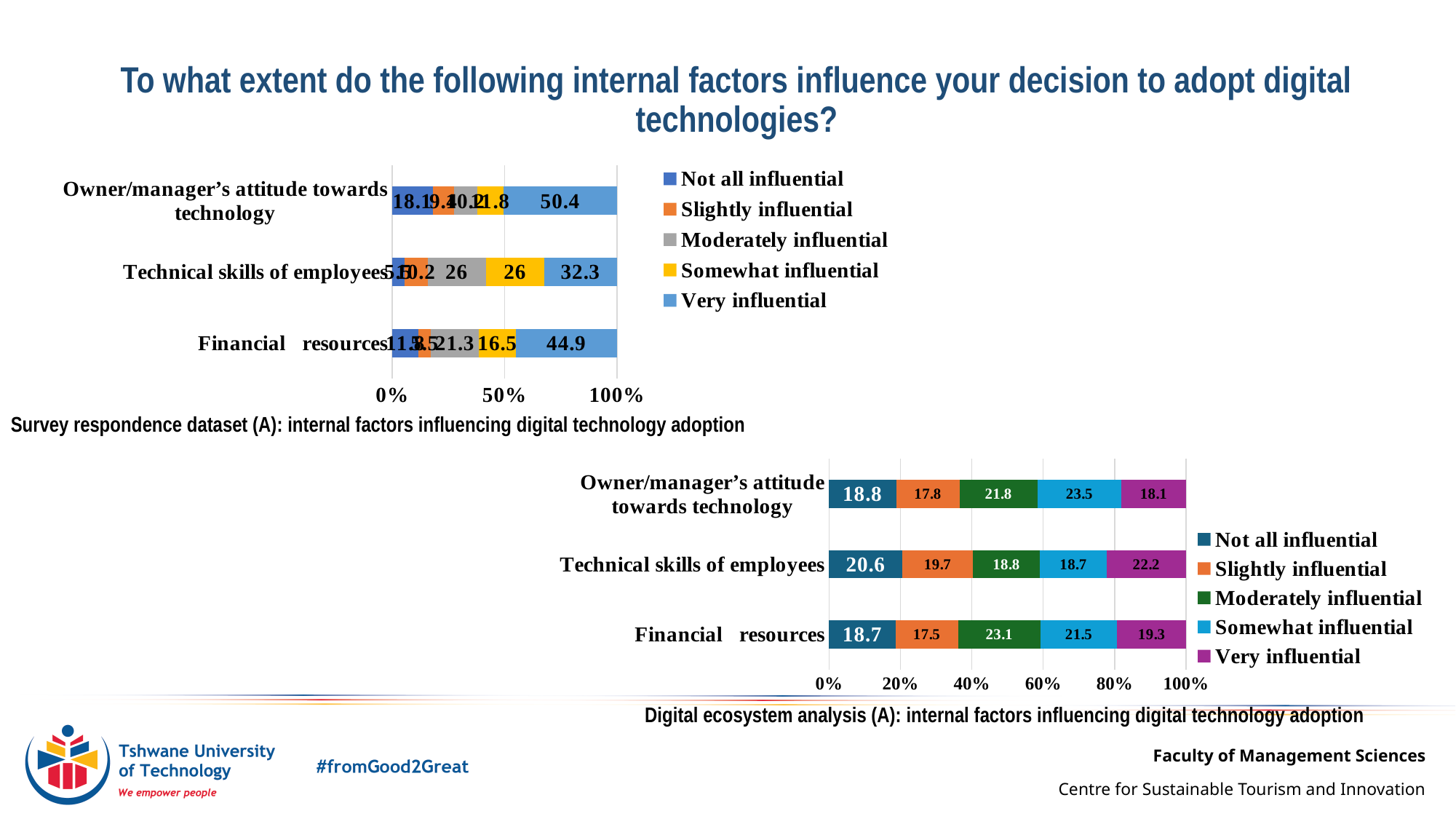
In the 'Survey respondence dataset (A)' chart, what is the value for 'Very influential' for Owner/manager's attitude towards technology? 50.4 What type of chart is the 'Survey respondence dataset (A)' chart? Stacked bar chart In the 'Survey respondence dataset (A)' chart, what is the difference between the 'Very influential' values for Financial resources and Technical skills of employees? 12.6 How many series does the legend of the 'Digital ecosystem analysis (A)' chart list? 5 In the 'Digital ecosystem analysis (A)' chart, which is larger for Owner/manager's attitude towards technology: 'Somewhat influential' or 'Very influential'? Somewhat influential In the 'Survey respondence dataset (A)' chart, what is the value for 'Somewhat influential' for Technical skills of employees? 26 In the 'Digital ecosystem analysis (A)' chart, what is the value for 'Very influential' for Technical skills of employees? 22.2 In the 'Digital ecosystem analysis (A)' chart, what is the difference between 'Moderately influential' and 'Slightly influential' for Financial resources? 5.6 In the 'Digital ecosystem analysis (A)' chart, what is the value for 'Moderately influential' for Financial resources? 23.1 In the 'Survey respondence dataset (A)' chart, what is the value for 'Very influential' for Financial resources? 44.9 In the 'Digital ecosystem analysis (A)' chart, which category has the highest 'Not all influential' value? Technical skills of employees In the 'Survey respondence dataset (A)' chart, which category has the highest 'Very influential' value? Owner/manager's attitude towards technology